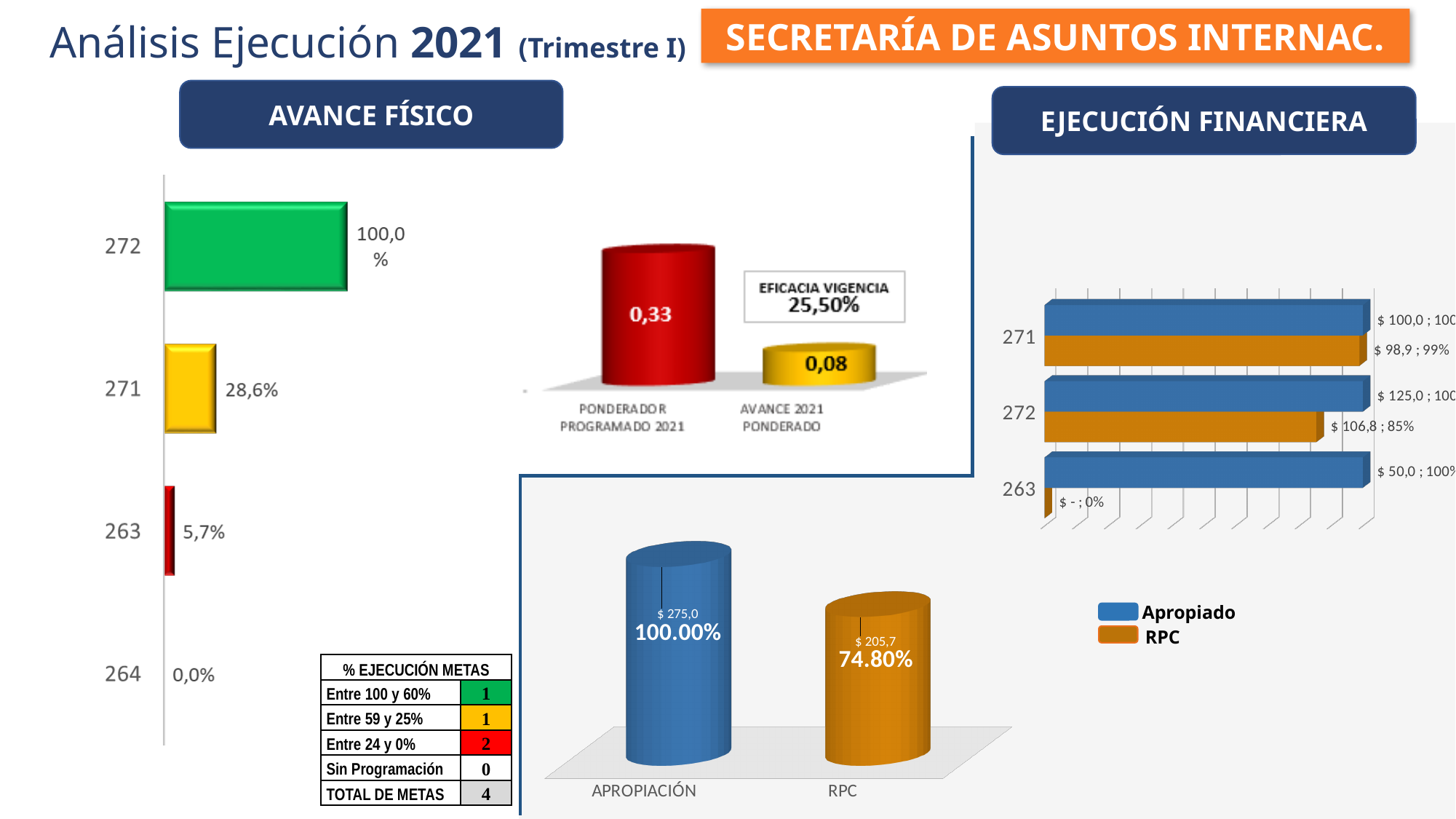
In the middle cylinder chart, what is the value for Ponderador Programado 2021? 0,33 In the middle cylinder chart, which is larger: Ponderador Programado 2021 or Avance 2021 Ponderado? Ponderador Programado 2021 In the Avance Físico bar chart on the left, what is the value for category 272? 100,0% In the Avance Físico bar chart on the left, which category has the lowest value? 264 In the Avance Físico bar chart on the left, what is the value for category 271? 28,6% In the bottom cylinder chart, what dollar value is shown for Apropiación? $ 275,0 What kind of chart is the Avance Físico chart on the left? Bar chart In the Avance Físico bar chart on the left, what is the difference between the values for 271 and 263? 22,9% In the bottom cylinder chart, what percentage is shown for RPC? 74.80% In the Avance Físico bar chart on the left, how many categories are shown? 4 In the Ejecución Financiera bar chart on the right, how many series does the legend list? 2 In the Ejecución Financiera bar chart on the right, what is the RPC value for category 272? $ 106,8 ; 85%